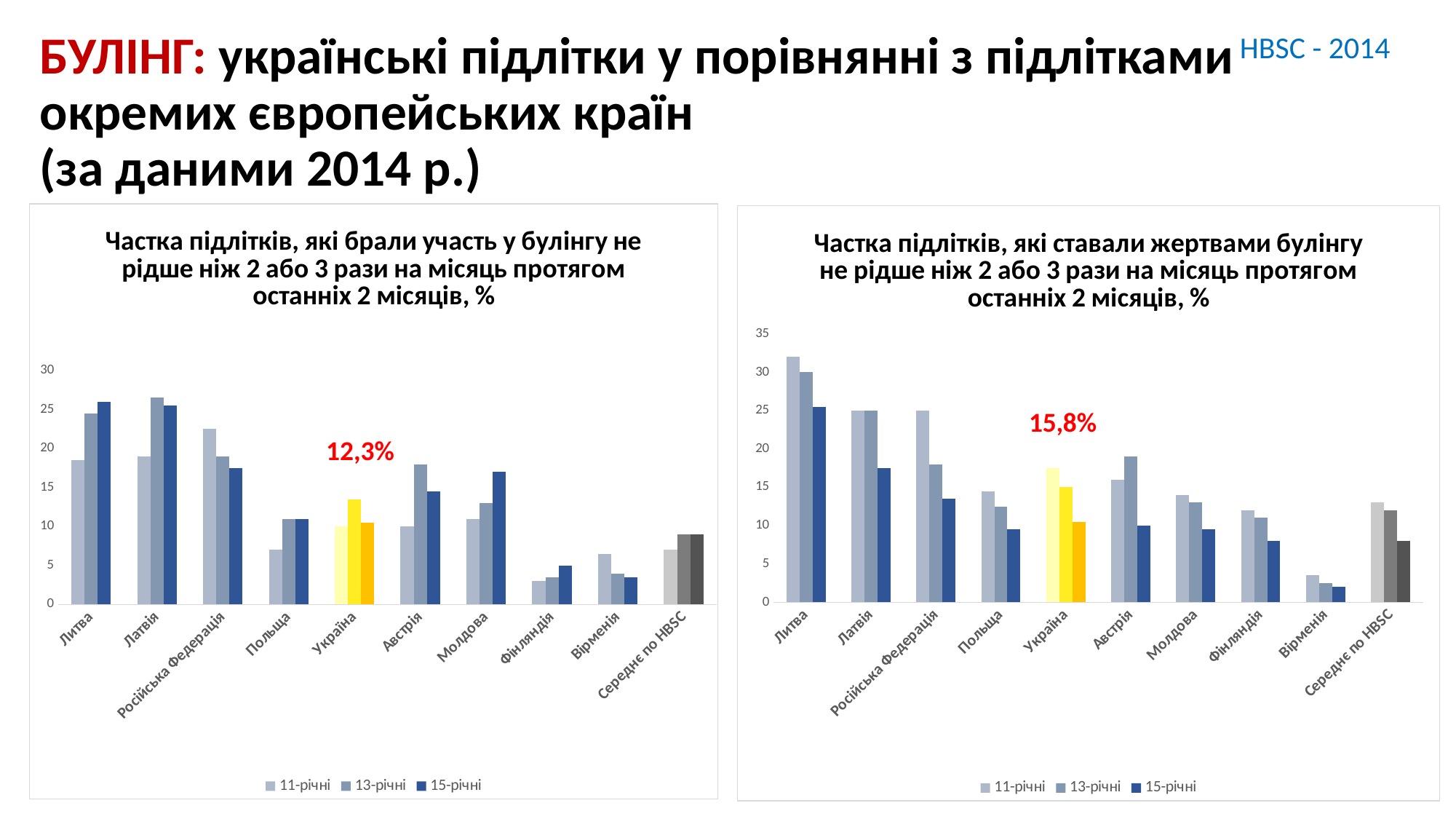
How many series does the legend of the left chart list? 3 In the left chart (participated in bullying), is the value for Польща 11-річні greater or less than 10? less What kind of chart is the left chart, titled "Частка підлітків, які брали участь у булінгу..."? bar chart In the left chart (participated in bullying), is the value for Латвія 13-річні greater or less than 25? greater How many countries/categories are shown on the x axis of the right chart ("Частка підлітків, які ставали жертвами булінгу...")? 10 In the right chart (victims of bullying), is the value for Литва 11-річні greater or less than 30? greater What percentage is annotated in red above the Україна bars in the right chart (victims of bullying)? 15,8% In the right chart (victims of bullying), do the values for Литва rise or fall from 11-річні to 15-річні? fall In the right chart (victims of bullying), which category has the highest value for 11-річні? Литва In the left chart (participated in bullying), which is larger: the 13-річні value for Україна or the 13-річні value for Польща? Україна In the left chart (participated in bullying), which category has the lowest value for 11-річні? Фінляндія In the right chart (victims of bullying), which category has the lowest value for 15-річні? Вірменія